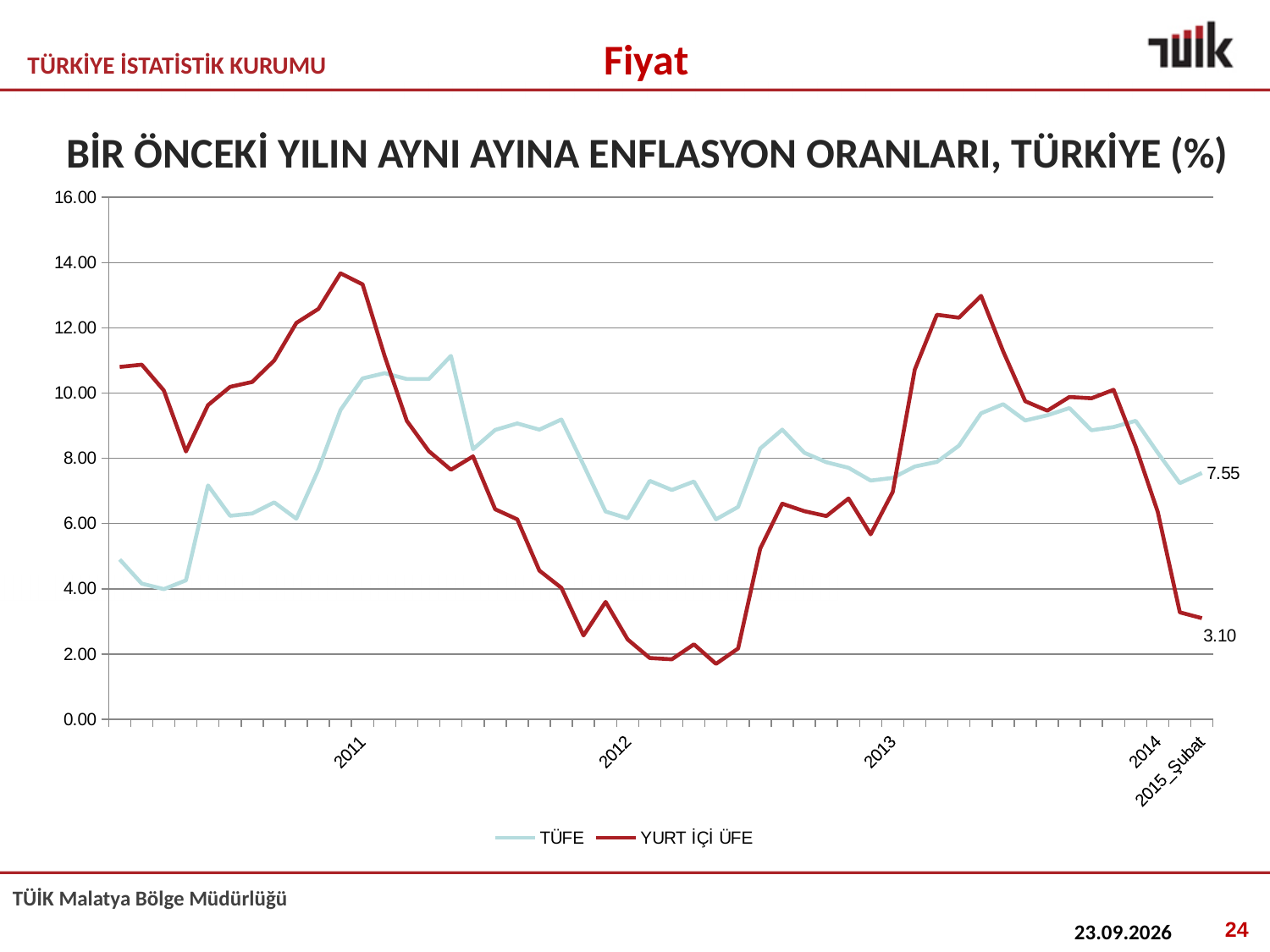
Does the YURT İÇİ ÜFE line rise or fall between 2014 and 2015_Şubat? fall How many series does the legend list? 2 What is the difference between the TÜFE and YURT İÇİ ÜFE values at 2015_Şubat? 4.45 Which series reaches the highest value anywhere on the chart? YURT İÇİ ÜFE Is the highest value reached by the YURT İÇİ ÜFE line greater or less than 12.00? greater What are the two series named in the legend? TÜFE and YURT İÇİ ÜFE What kind of chart is shown on the slide? Line chart What is the title of the chart? BİR ÖNCEKİ YILIN AYNI AYINA ENFLASYON ORANLARI, TÜRKİYE (%) What is the YURT İÇİ ÜFE value at 2015_Şubat? 3.10 What is the TÜFE value at 2015_Şubat? 7.55 Is the TÜFE value at 2015_Şubat greater or less than 8.00? less At 2015_Şubat, which series has the larger value, TÜFE or YURT İÇİ ÜFE? TÜFE